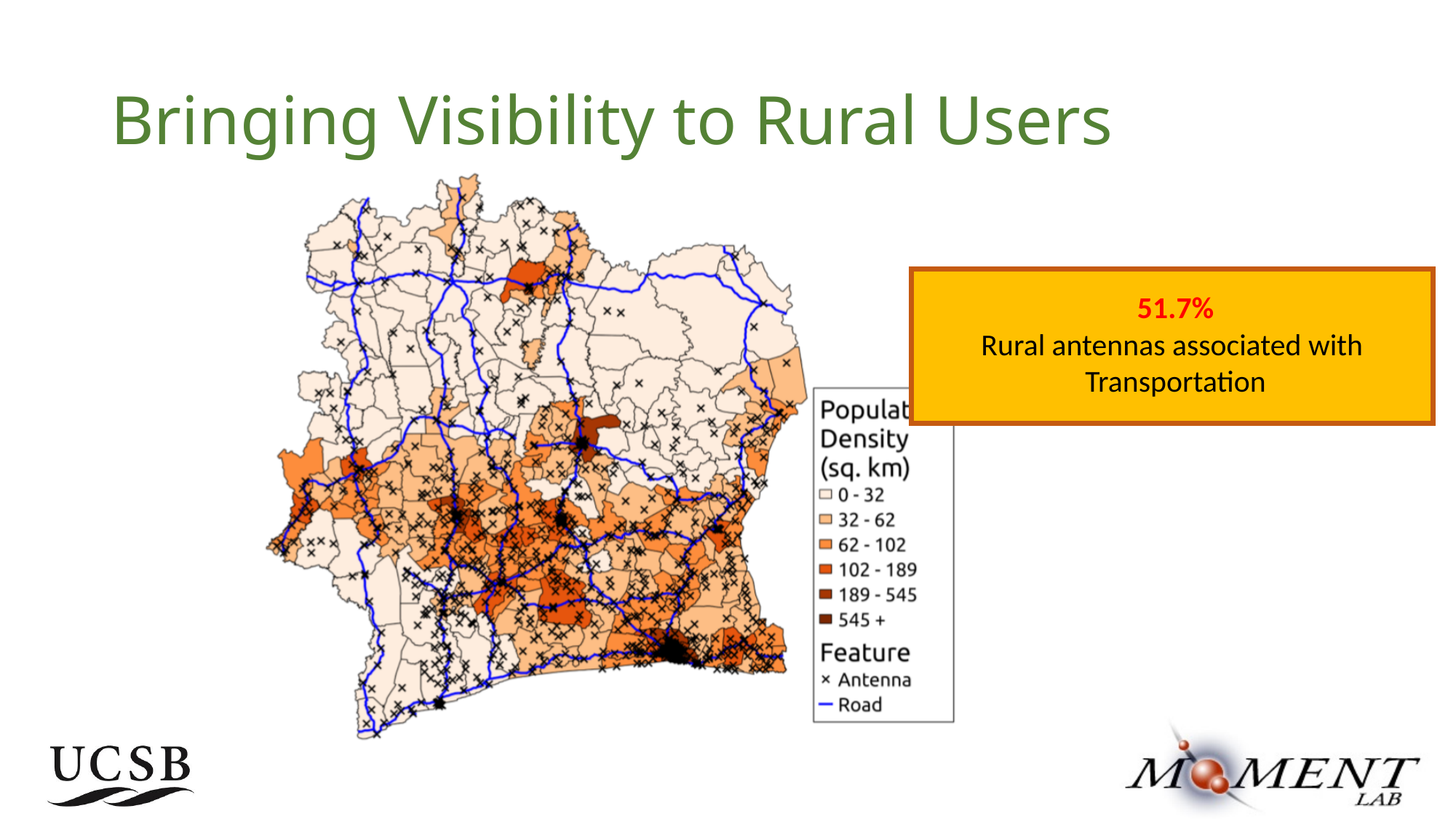
Which symbol represents an antenna in the map legend? × What density range comes between 62 - 102 and 189 - 545 in the map legend? 102 - 189 What kind of chart is shown on the slide? A map (choropleth map) What is the lowest population density range shown in the map legend? 0 - 32 What is the highest population density class shown in the map legend? 545 + What unit is the population density on the map measured in? sq. km How many features does the map legend list under 'Feature'? 2 How many population density classes does the map legend list? 6